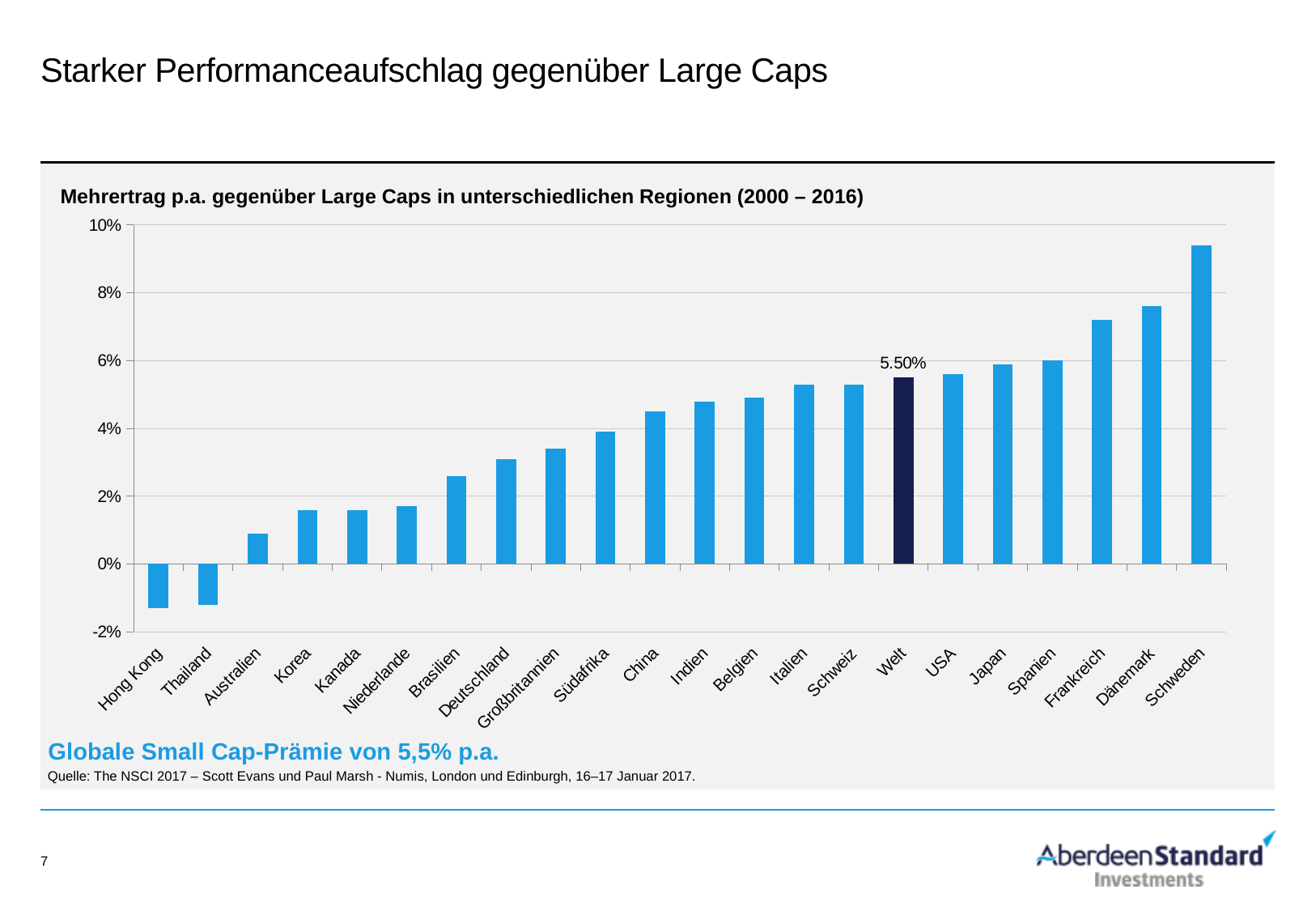
Which has the larger value, Deutschland or Brasilien? Deutschland Is the value for Schweden greater or less than 8%? greater Is the value for Brasilien greater or less than 2%? greater Which category has the highest value in the chart? Schweden Is the value for Australien greater or less than 2%? less What kind of chart is shown on the slide? Bar chart What value is labelled on the bar for Welt? 5.50% How many categories are shown on the x axis of the chart? 22 Which has the larger value, Schweden or Dänemark? Schweden Do the values generally rise or fall from left to right along the x axis? Rise